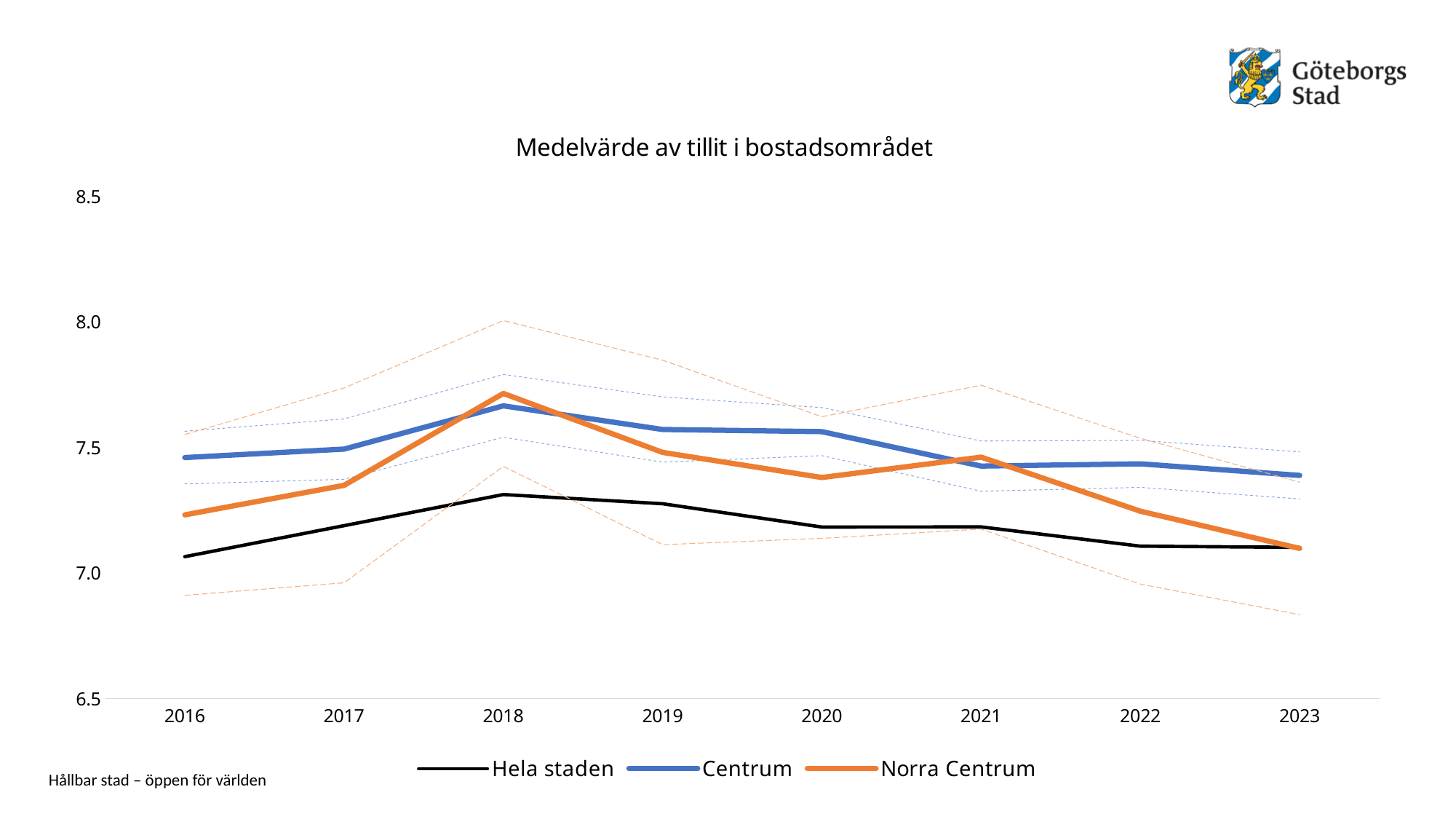
Is the value for Centrum in 2018 greater or less than 7.5? greater What is the title of the chart? Medelvärde av tillit i bostadsområdet How many years are shown on the x axis? 8 Is the value for Norra Centrum in 2023 greater or less than 7.5? less How many series does the legend list? 3 What kind of chart is shown on the slide? line chart In which year does the Centrum line reach its highest value? 2018 Is the value for Hela staden in 2016 greater or less than 7.5? less In 2020, which is larger: Centrum or Hela staden? Centrum Which colour is used for the Norra Centrum line? orange Does the Hela staden line rise or fall from 2018 to 2023? fall In which year does the Norra Centrum line reach its highest value? 2018